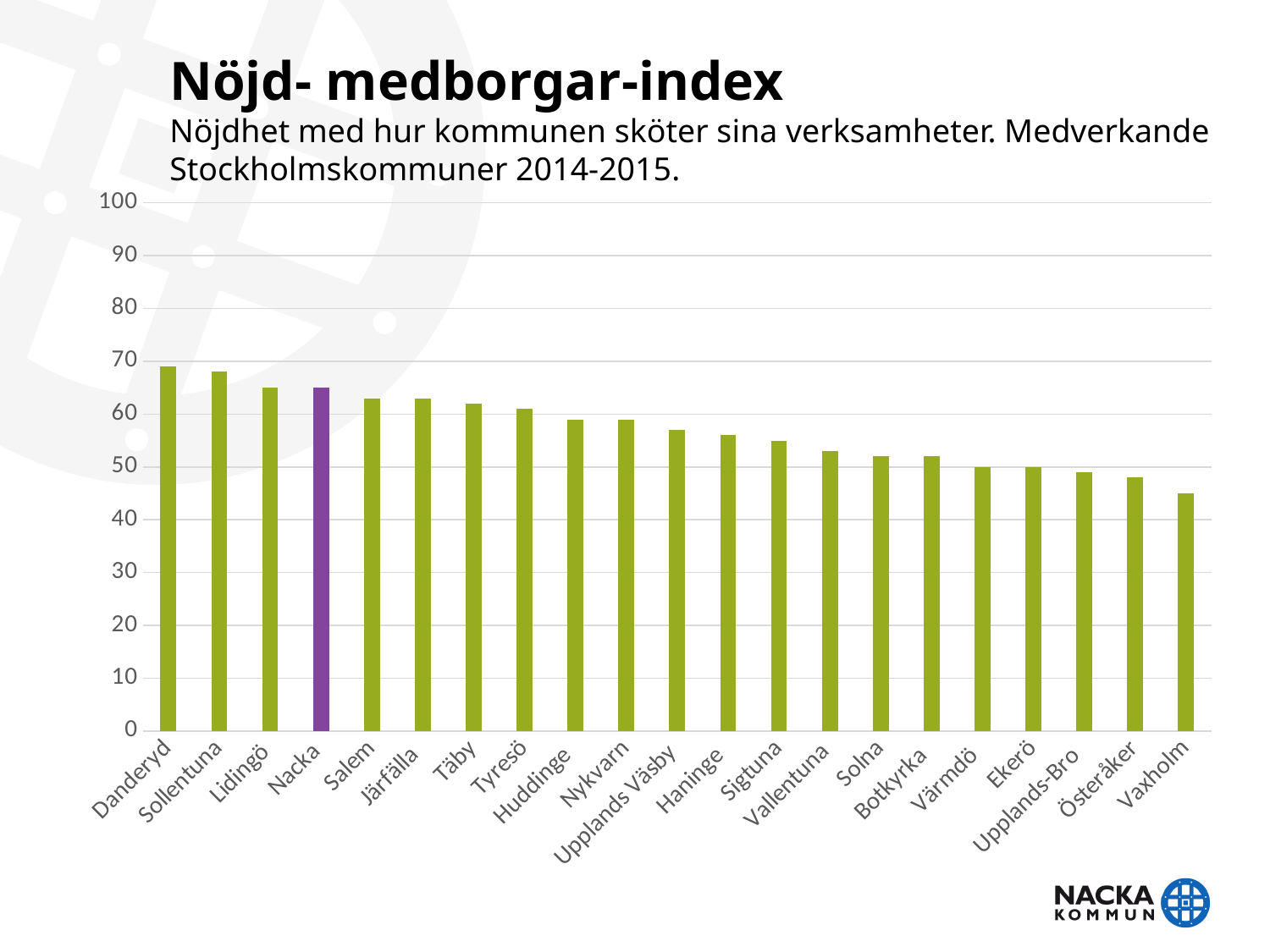
Is the value for Sigtuna greater or less than 60? less What kind of chart is shown on the slide? bar chart Is the value for Danderyd greater or less than 60? greater Which municipality has the lowest value in the chart? Vaxholm Which municipality's bar is shown in a different colour (purple) from the others? Nacka How many municipalities are shown on the x axis of the chart? 21 Is the value for Haninge greater or less than 50? greater Which has the larger value, Nacka or Haninge? Nacka Which has the larger value, Danderyd or Vaxholm? Danderyd Do the values rise or fall from left to right along the x axis? fall